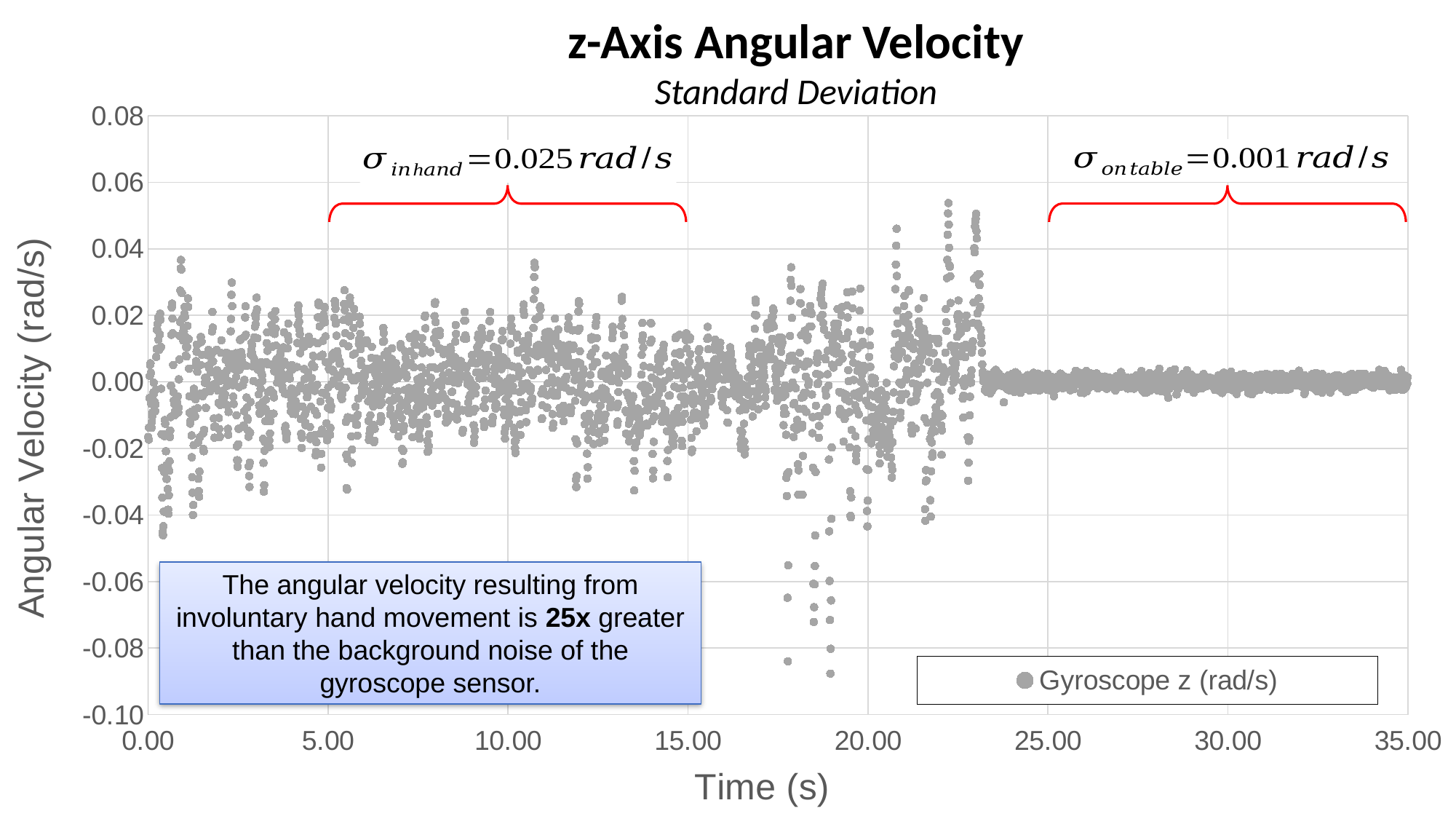
What is the title of the chart? z-Axis Angular Velocity Which segment has the larger annotated standard deviation, in hand or on table? in hand What is the name of the series shown in the legend? Gyroscope z (rad/s) How many series does the legend list? 1 What is the standard deviation of the angular velocity annotated for the in-hand segment? 0.025 rad/s What is the label of the x axis? Time (s) Is the highest plotted angular velocity value greater or less than 0.06 rad/s? less What kind of chart is shown on the slide? scatter chart According to the text box, how many times greater is the angular velocity from involuntary hand movement than the gyroscope's background noise? 25x What is the difference between the in-hand standard deviation and the on-table standard deviation? 0.024 rad/s Is the lowest plotted angular velocity value greater or less than -0.08 rad/s? less What is the standard deviation of the angular velocity annotated for the on-table segment? 0.001 rad/s